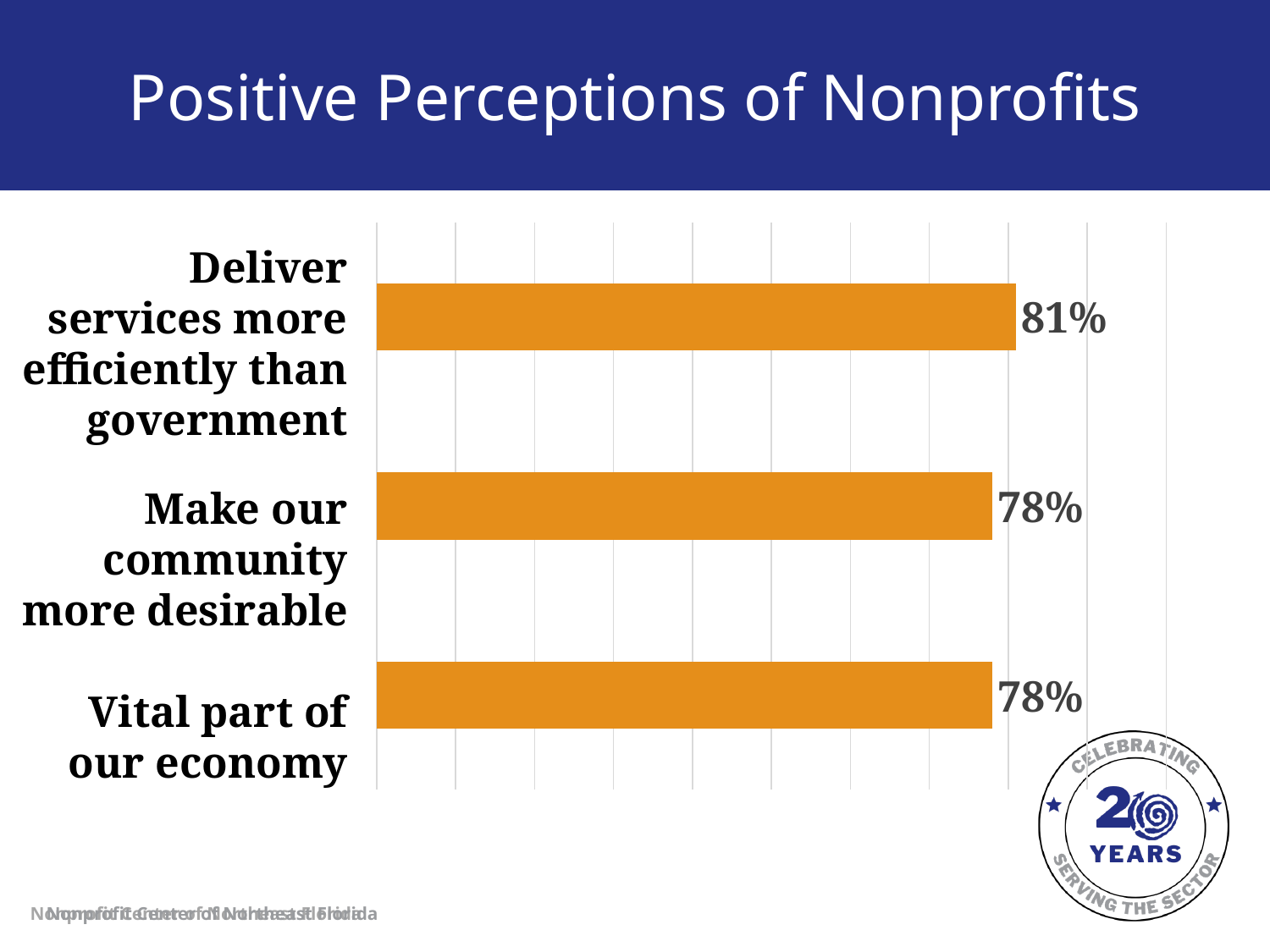
How many categories are shown in the chart? 3 What is the title of the slide? Positive Perceptions of Nonprofits What percentage is shown for "Deliver services more efficiently than government"? 81% What is the value for "Make our community more desirable"? 78% Which is larger: the value for "Deliver services more efficiently than government" or the value for "Make our community more desirable"? Deliver services more efficiently than government Which category has the highest value? Deliver services more efficiently than government What kind of chart is shown on the slide? Bar chart What percentage is shown for "Vital part of our economy"? 78% What is the difference between the value for "Deliver services more efficiently than government" and the value for "Vital part of our economy"? 3 percentage points What colour are the bars in the chart? Orange